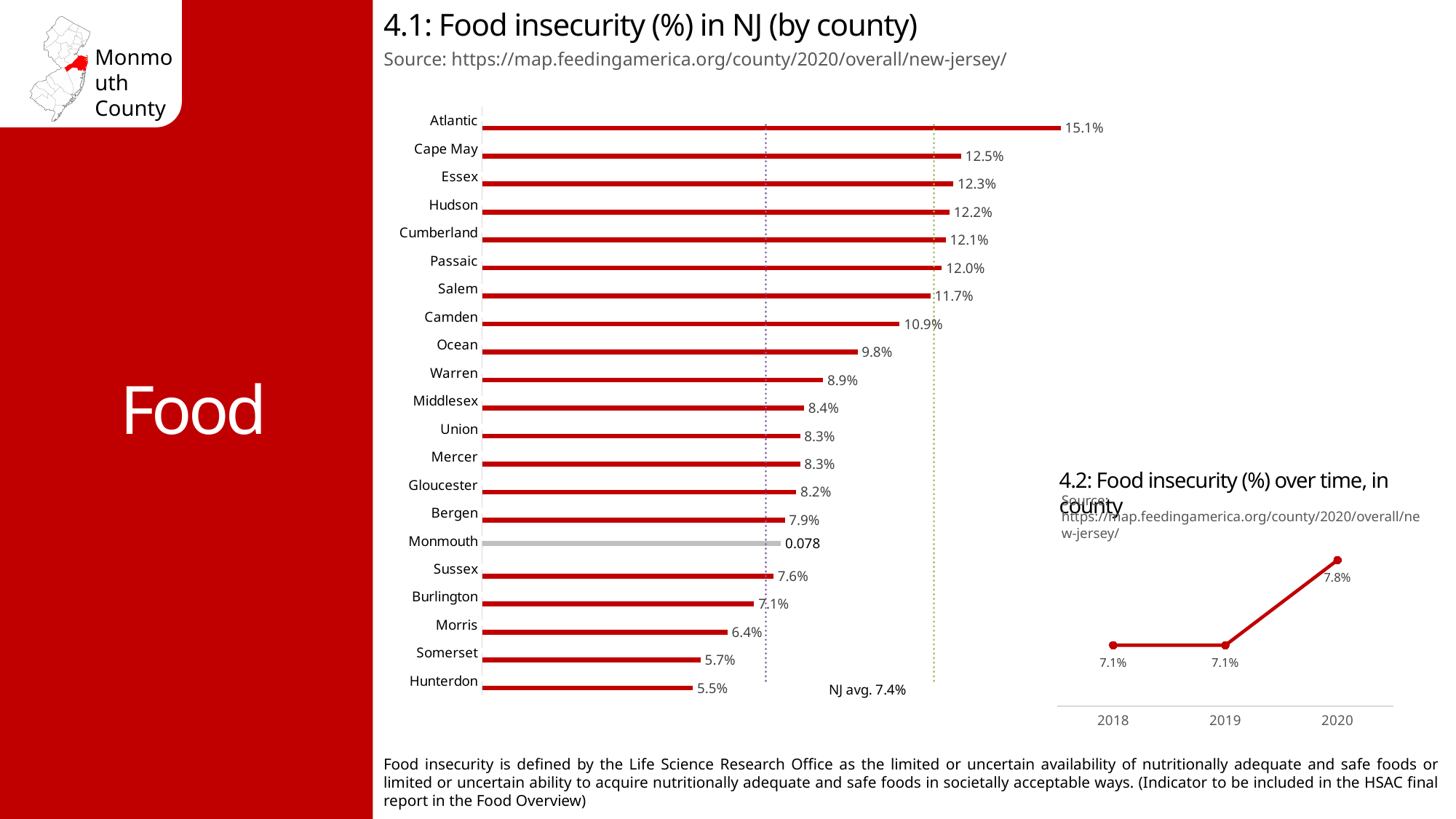
In chart 4.1 (Food insecurity in NJ by county), what is the value for Atlantic? 15.1% In chart 4.1 (Food insecurity in NJ by county), which is higher, Ocean or Warren? Ocean In chart 4.1 (Food insecurity in NJ by county), which county has the highest food insecurity? Atlantic What kind of chart is chart 4.1 (Food insecurity in NJ by county)? Bar chart In chart 4.2 (Food insecurity over time in county), what is the value for 2020? 7.8% In chart 4.1 (Food insecurity in NJ by county), how many counties are shown? 21 In chart 4.1 (Food insecurity in NJ by county), what is the difference between Atlantic and Hunterdon? 9.6% In chart 4.1 (Food insecurity in NJ by county), what value is labelled for Monmouth? 0.078 In chart 4.1 (Food insecurity in NJ by county), which county has the lowest food insecurity? Hunterdon In chart 4.1 (Food insecurity in NJ by county), what NJ average is noted on the chart? 7.4% In chart 4.2 (Food insecurity over time in county), what is the difference between 2019 and 2020? 0.7% In chart 4.2 (Food insecurity over time in county), does the value rise or fall from 2018 to 2020? Rise